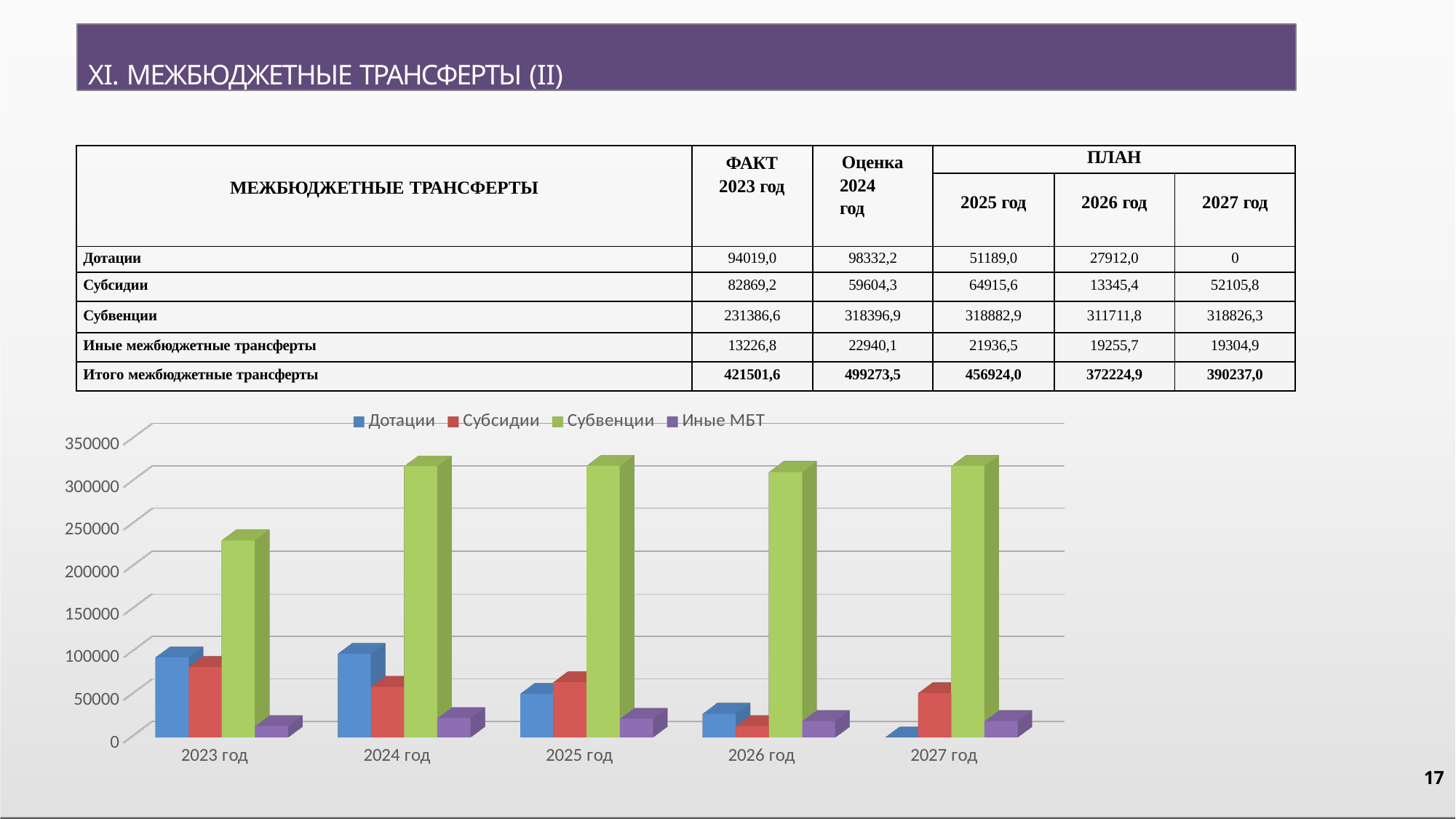
According to the table, what is the difference between Дотации in 2024 год and 2023 год? 4313,2 In 2023 год, which is larger: Дотации or Субсидии? Дотации How many series does the chart legend list? 4 Is the value for Субвенции in 2023 год greater or less than 200000? greater How many year categories are shown on the x axis of the chart? 5 Which year has the lowest Дотации bar? 2027 год Which series has the highest bar for 2024 год? Субвенции Do the Дотации bars rise or fall from 2024 год to 2027 год? fall Is the value for Дотации in 2026 год greater or less than 50000? less According to the table, what is the value of Субвенции for 2025 год? 318882,9 What are the four legend entries of the chart? Дотации, Субсидии, Субвенции, Иные МБТ What kind of chart is shown on the slide? bar chart